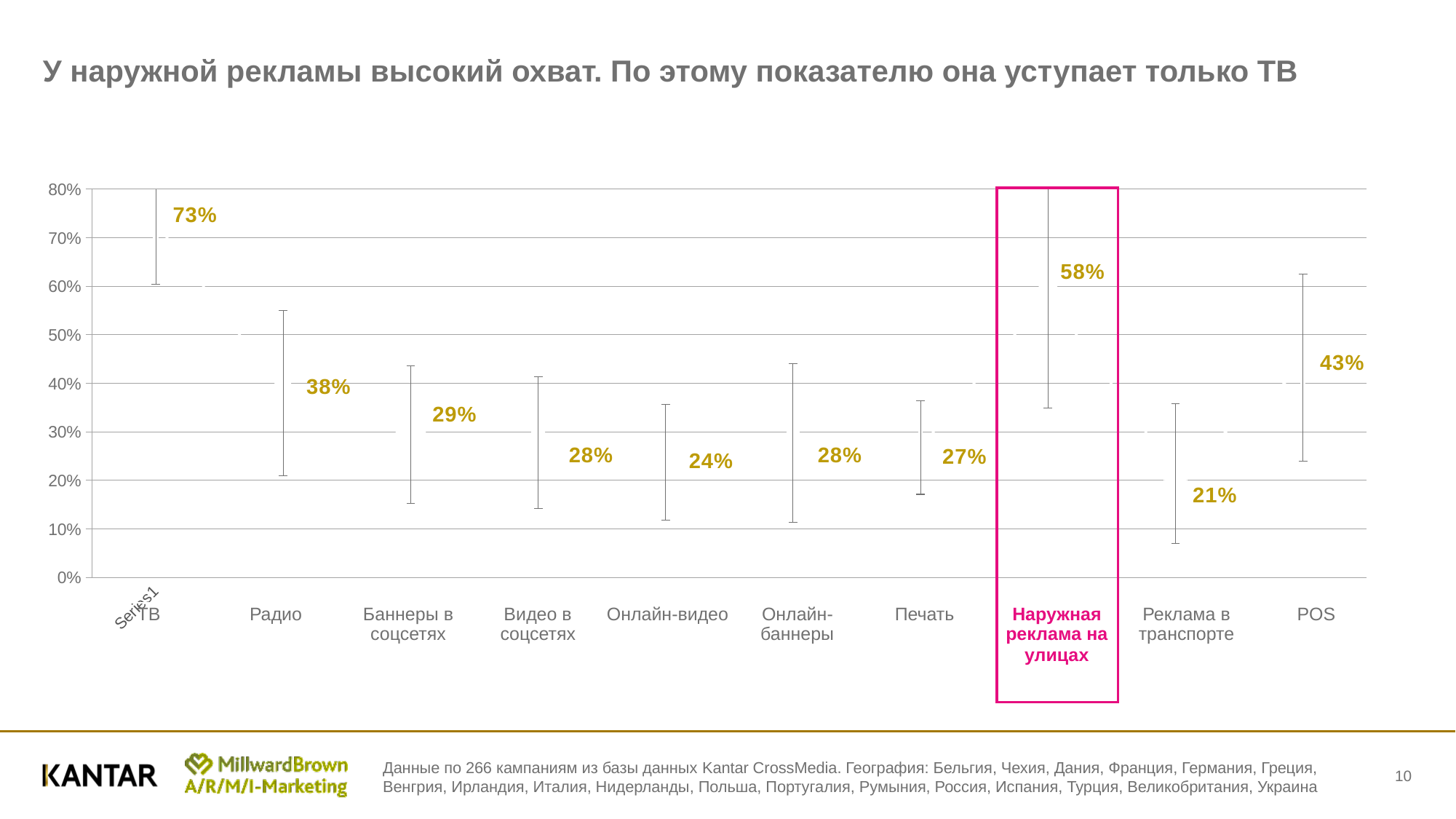
What is the value for Реклама в транспорте? 21% What is the value for ТВ? 73% What is the value for POS? 43% What is the value for Онлайн-видео? 24% Which category has the highest value? ТВ Which is larger, the value for Радио or the value for POS? POS Which category has the lowest value? Реклама в транспорте How many categories are shown on the x axis? 10 Which category is highlighted with a pink box on the chart? Наружная реклама на улицах What is the value for Наружная реклама на улицах? 58% What is the difference between the values for ТВ and Наружная реклама на улицах? 15% What is the difference between the values for Радио and Печать? 11%